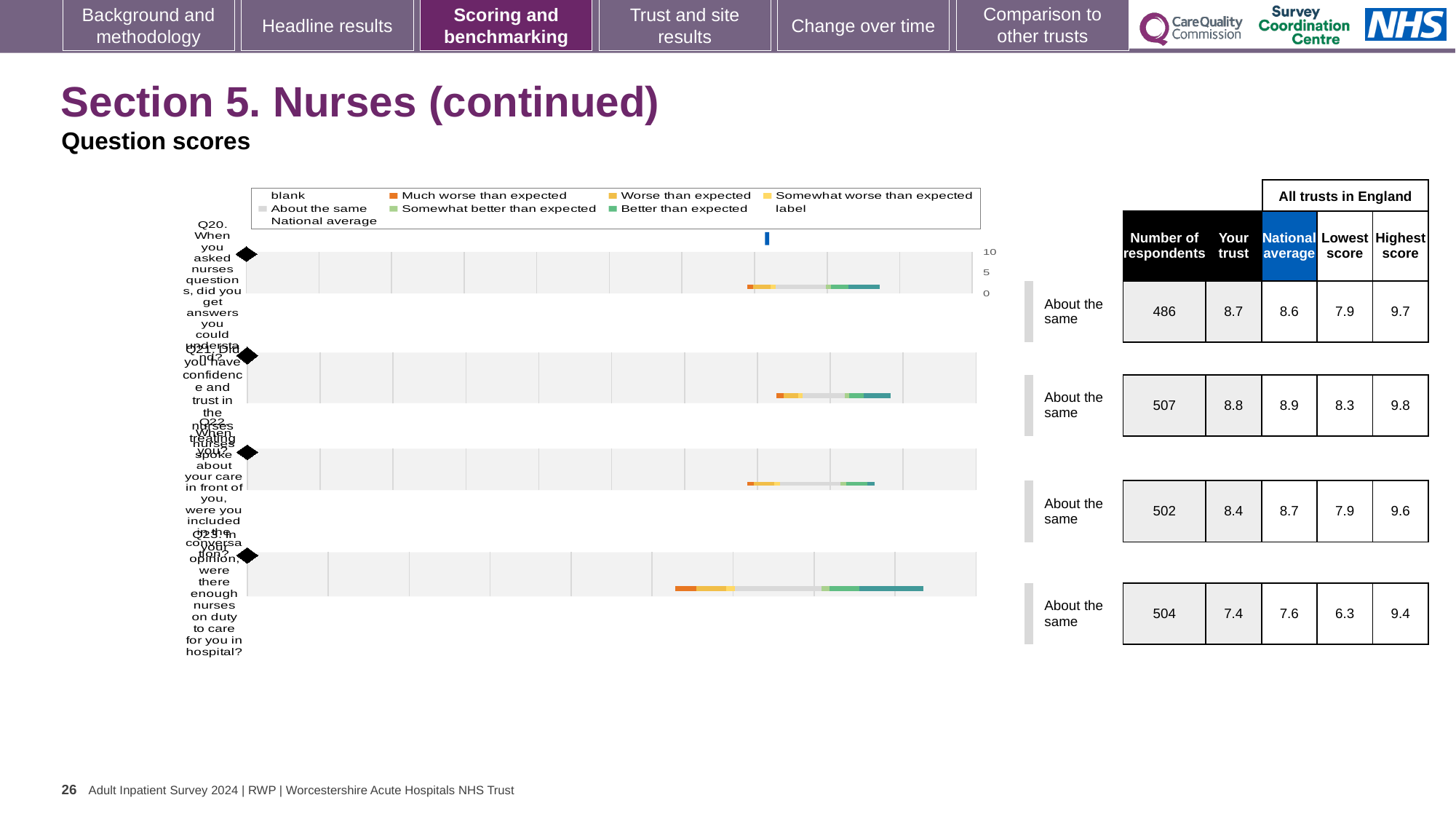
What kind of chart is used to show the question scores on this slide? bar chart What is the highest score among all trusts in England for Q21? 9.8 For Q20, which is larger: the 'Your trust' score or the national average? Your trust What is the number of respondents for Q20? 486 How many questions (categories) are plotted in the chart? 4 Which question has the lowest 'Your trust' score? Q23 Which question has the highest 'Your trust' score? Q21 How many entries does the chart legend list? 9 What is the difference between the 'Your trust' score and the national average for Q22? 0.3 Which legend entry is shown in orange in the chart? Much worse than expected What is the 'Your trust' score for Q23? 7.4 What is the national average score for Q22? 8.7